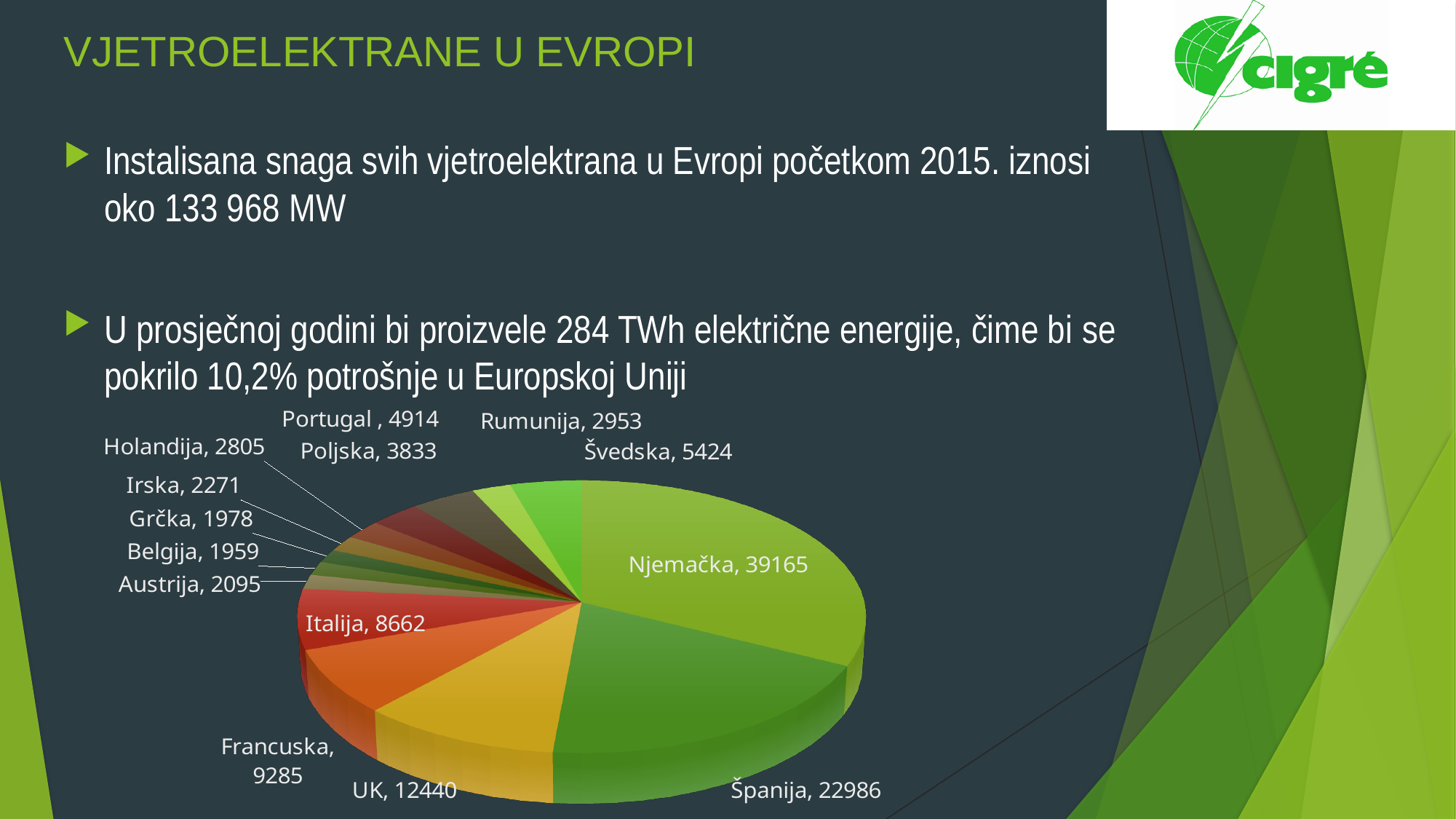
What is the value shown for Njemačka in the pie chart? 39165 What is the value shown for UK in the pie chart? 12440 Which country has the largest slice in the pie chart? Njemačka What is the value shown for Švedska in the pie chart? 5424 What is the value shown for Španija in the pie chart? 22986 How many countries (slices) are shown in the pie chart? 14 What type of chart is shown on the slide? pie chart Which has a larger value, Portugal or Poljska? Portugal What is the difference between the values for Njemačka and Španija? 16179 What is the value shown for Holandija in the pie chart? 2805 What is the difference between the values for UK and Francuska? 3155 Which has a larger value, Italija or Francuska? Francuska